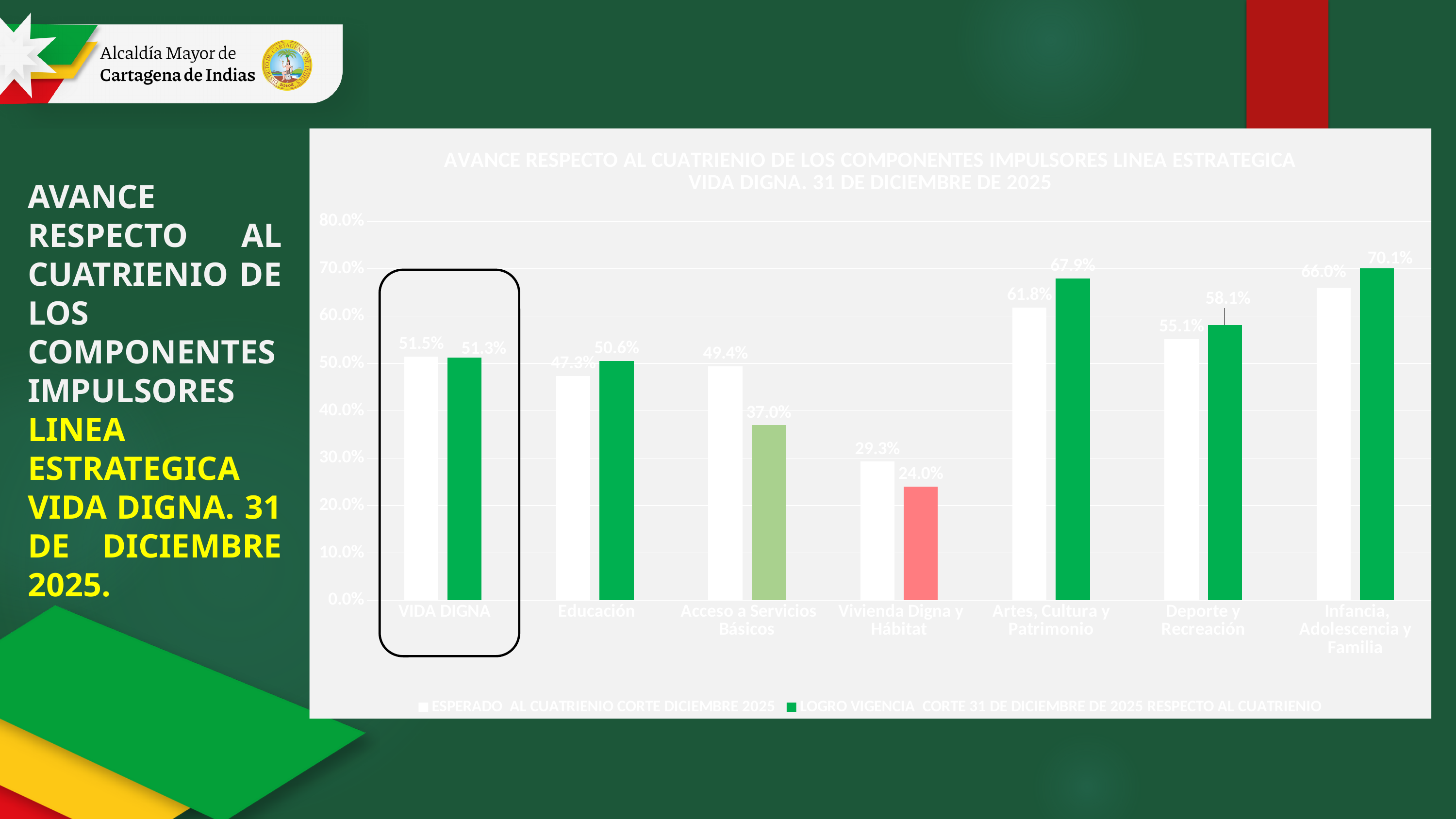
What is the difference between the LOGRO VIGENCIA and ESPERADO AL CUATRIENIO values for Artes, Cultura y Patrimonio? 6.1% What is the LOGRO VIGENCIA value for Acceso a Servicios Básicos? 37.0% For Acceso a Servicios Básicos, which is larger: the ESPERADO AL CUATRIENIO value or the LOGRO VIGENCIA value? ESPERADO AL CUATRIENIO What is the ESPERADO AL CUATRIENIO value for Vivienda Digna y Hábitat? 29.3% Is the LOGRO VIGENCIA value for Deporte y Recreación greater or less than 50.0%? greater Which category has the highest LOGRO VIGENCIA value? Infancia, Adolescencia y Familia How many series does the chart legend list? 2 Which category has the lowest ESPERADO AL CUATRIENIO value? Vivienda Digna y Hábitat What is the LOGRO VIGENCIA value for Educación? 50.6% What type of chart is shown on the slide? Bar chart What colour is the LOGRO VIGENCIA bar for Vivienda Digna y Hábitat? Red How many categories are shown on the x axis of the chart? 7